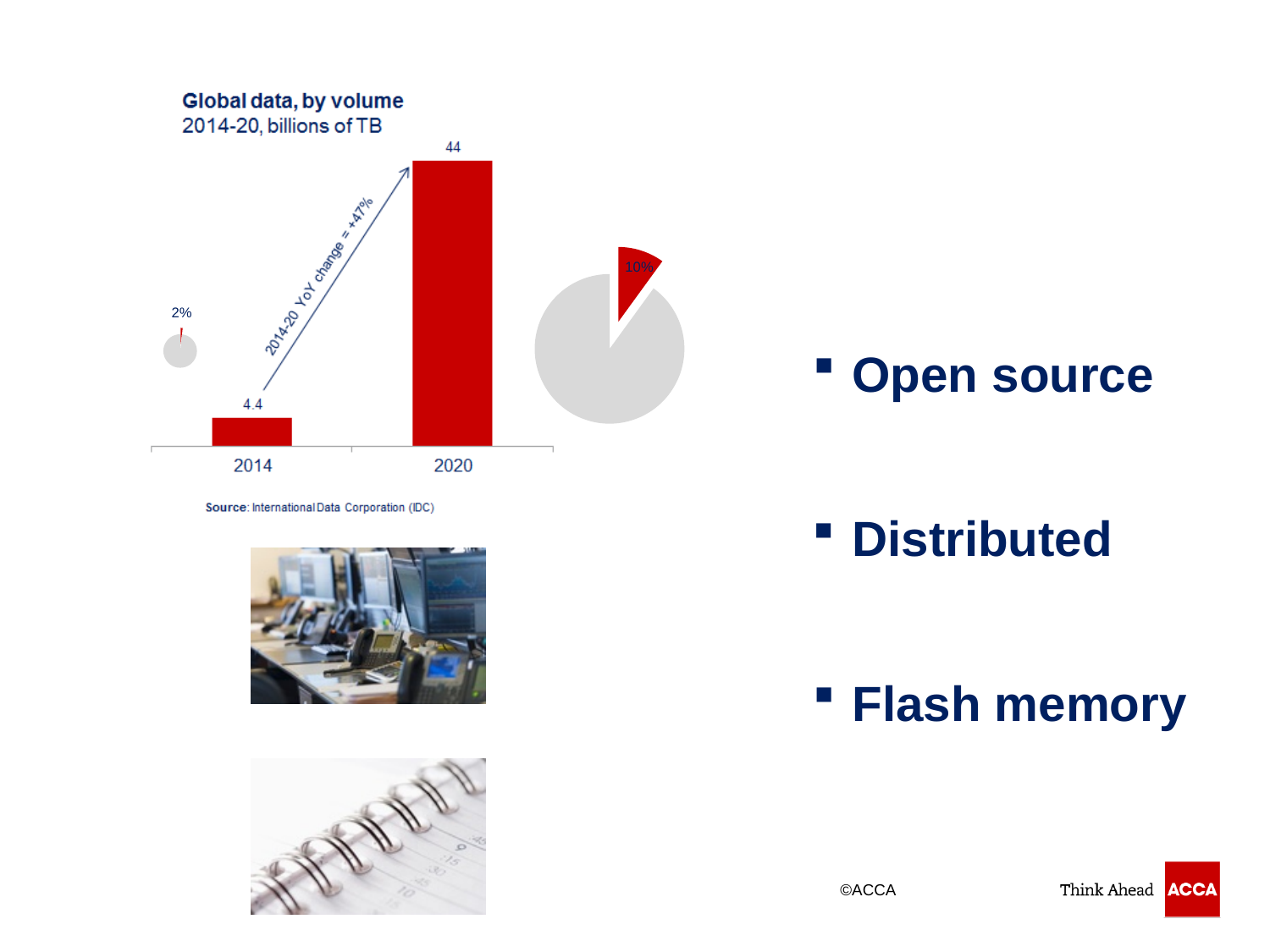
In the 'Global data, by volume' chart, what is the value for 2014? 4.4 In the 'Global data, by volume' chart, is the value for 2020 larger or smaller than the value for 2014? larger In the 'Global data, by volume' chart, which year has the higher value? 2020 How many bars are plotted in the 'Global data, by volume' chart? 2 In the 'Global data, by volume' chart, which year has the lower value? 2014 What share is labelled on the red slice of the small pie chart next to the 2014 bar? 2% In the 'Global data, by volume' chart, what is the value for 2020? 44 What share is labelled on the red slice of the larger pie chart next to the 2020 bar? 10% What 2014-20 YoY change is annotated on the 'Global data, by volume' chart? +47% In the 'Global data, by volume' chart, do the values rise or fall from 2014 to 2020? rise What kind of chart is 'Global data, by volume'? bar chart In the 'Global data, by volume' chart, what is the difference between the 2020 and 2014 values? 39.6